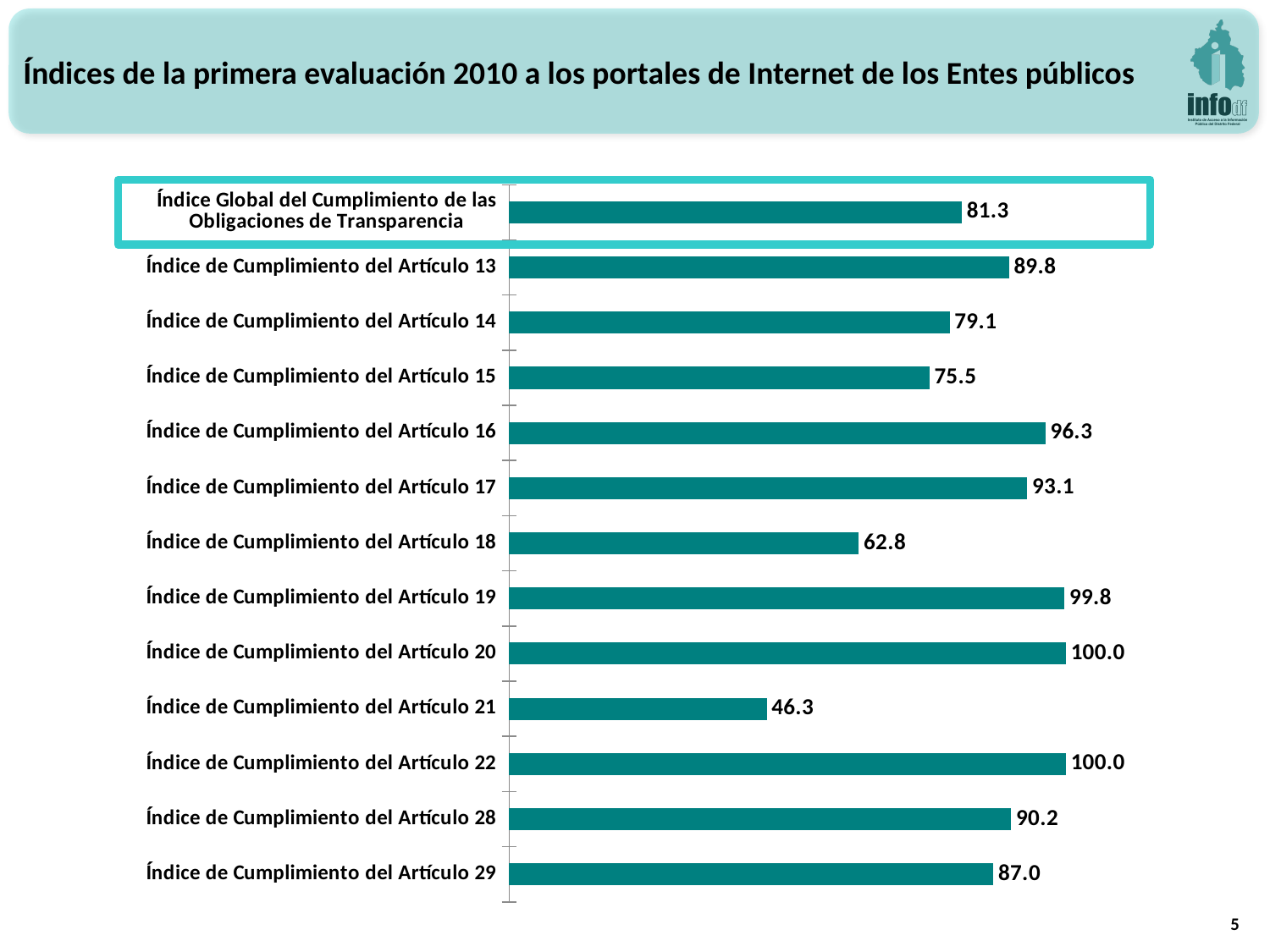
What is the value for Índice de Cumplimiento del Artículo 18? 62.8 Which two categories both have a value of 100.0? Índice de Cumplimiento del Artículo 20 and Índice de Cumplimiento del Artículo 22 Which is larger, the value for Índice de Cumplimiento del Artículo 28 or Índice de Cumplimiento del Artículo 29? Índice de Cumplimiento del Artículo 28 Which category has the lowest value? Índice de Cumplimiento del Artículo 21 What is the difference between the values for Índice de Cumplimiento del Artículo 16 and Índice de Cumplimiento del Artículo 17? 3.2 Which is larger, the value for Índice de Cumplimiento del Artículo 14 or Índice de Cumplimiento del Artículo 15? Índice de Cumplimiento del Artículo 14 What is the value for Índice Global del Cumplimiento de las Obligaciones de Transparencia? 81.3 What is the difference between the values for Índice de Cumplimiento del Artículo 20 and Índice de Cumplimiento del Artículo 21? 53.7 How many bars are shown in the chart? 13 What is the value for Índice de Cumplimiento del Artículo 13? 89.8 What kind of chart is shown on the slide? Bar chart What is the value for Índice de Cumplimiento del Artículo 21? 46.3